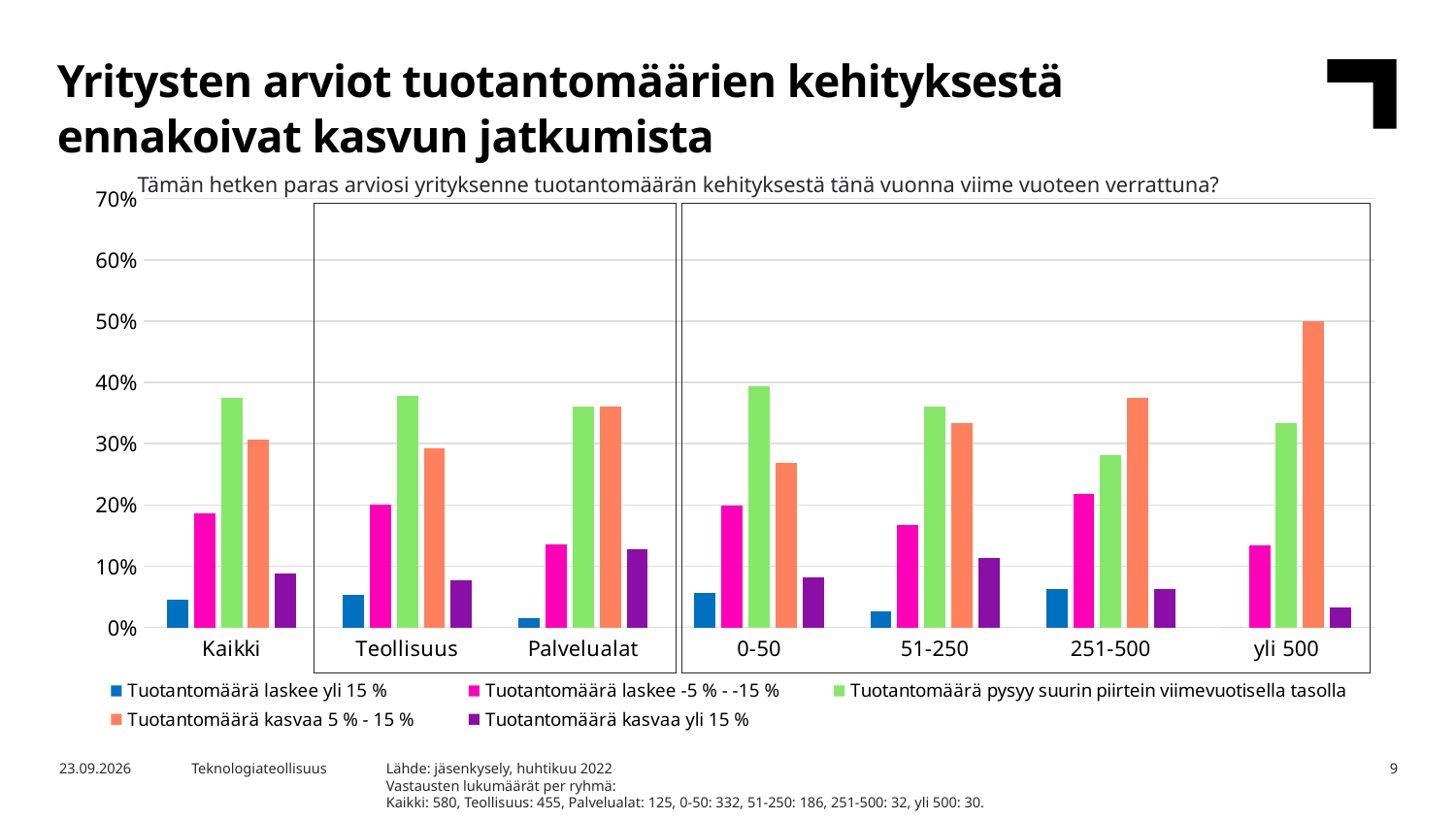
Which category has the highest value for 'Tuotantomäärä kasvaa 5 % - 15 %'? yli 500 What kind of chart is shown on the slide? bar chart In the '251-500' category, which is larger: 'Tuotantomäärä kasvaa 5 % - 15 %' or 'Tuotantomäärä pysyy suurin piirtein viimevuotisella tasolla'? Tuotantomäärä kasvaa 5 % - 15 % Is the value of 'Tuotantomäärä pysyy suurin piirtein viimevuotisella tasolla' for '0-50' greater or less than 30%? greater How many categories are shown along the x axis of the chart? 7 Is the value of 'Tuotantomäärä kasvaa 5 % - 15 %' for 'yli 500' greater or less than 40%? greater Is the value of 'Tuotantomäärä laskee -5 % - -15 %' for 'Kaikki' greater or less than 30%? less How many series does the chart's legend list? 5 Which series has the lowest value in the 'Kaikki' category? Tuotantomäärä laskee yli 15 % What question is shown as the chart's title above the plot area? Tämän hetken paras arviosi yrityksenne tuotantomäärän kehityksestä tänä vuonna viime vuoteen verrattuna? In the 'Kaikki' category, which is larger: 'Tuotantomäärä pysyy suurin piirtein viimevuotisella tasolla' or 'Tuotantomäärä kasvaa 5 % - 15 %'? Tuotantomäärä pysyy suurin piirtein viimevuotisella tasolla